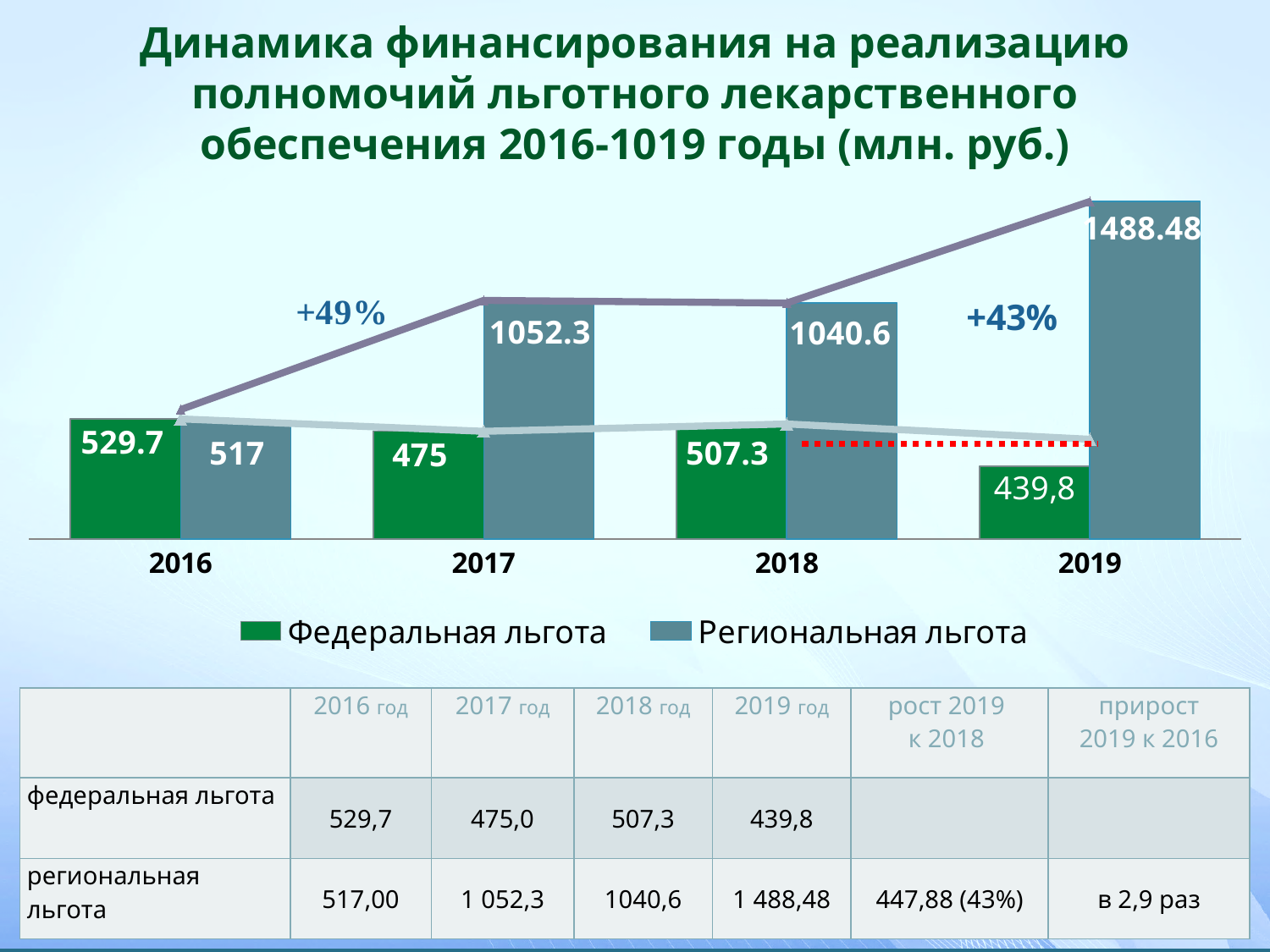
What is the value for Федеральная льгота in 2019? 439,8 How many years are shown on the x axis? 4 What is the value for Региональная льгота in 2019? 1488.48 In which year is Региональная льгота highest? 2019 What is the difference between Региональная льгота in 2019 and in 2018? 447.88 What kind of chart is shown on the slide? combination bar and line chart What is the value for Федеральная льгота in 2017? 475 In which year is Федеральная льгота lowest? 2019 How many series does the legend list? 2 What is the value for Региональная льгота in 2016? 517 What percentage growth is annotated between 2016 and 2017 for Региональная льгота? +49% Which is larger in 2016: Федеральная льгота or Региональная льгота? Федеральная льгота